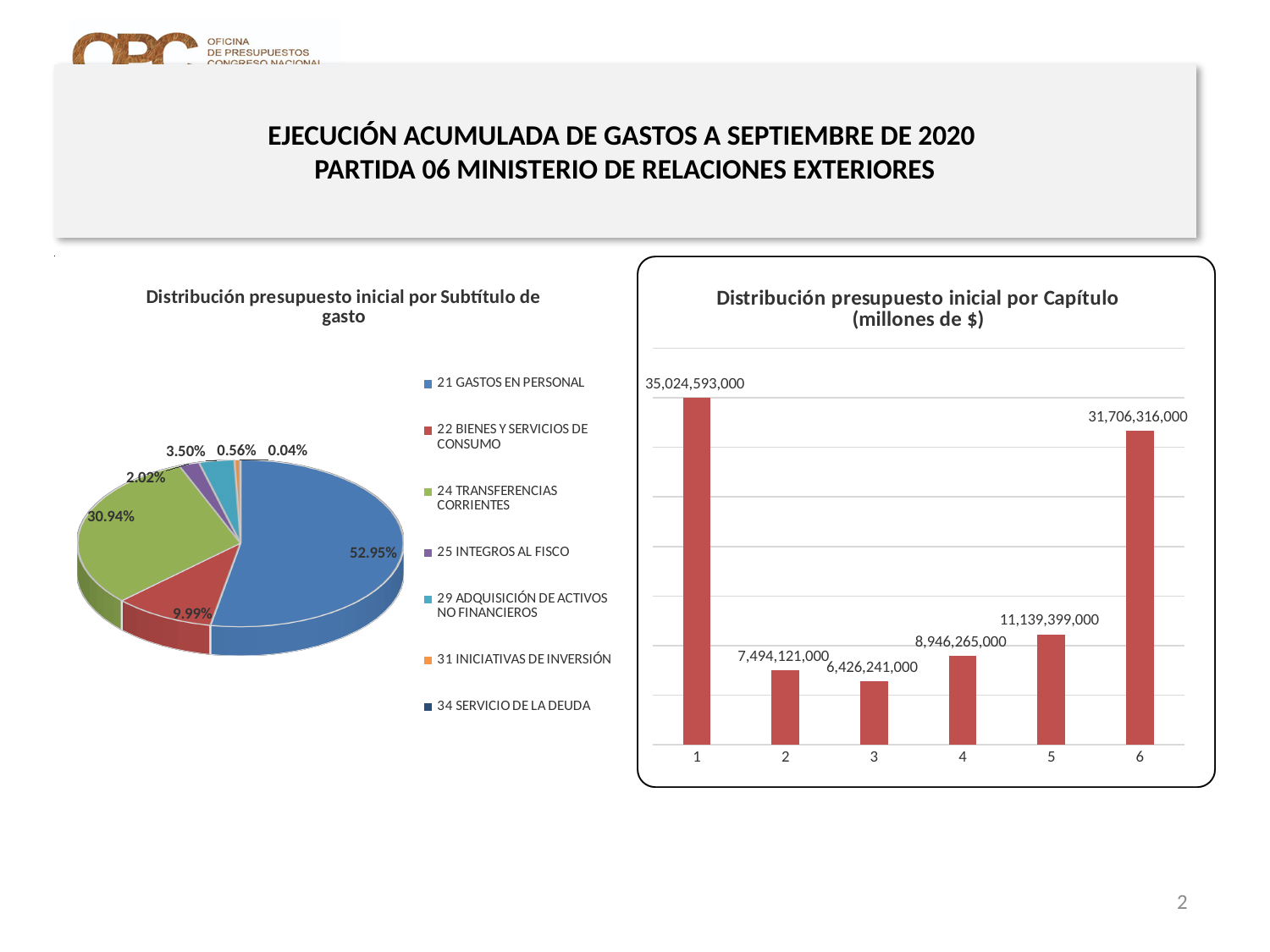
In the pie chart 'Distribución presupuesto inicial por Subtítulo de gasto', which category has the smallest share? 34 SERVICIO DE LA DEUDA In the pie chart 'Distribución presupuesto inicial por Subtítulo de gasto', what share does 24 TRANSFERENCIAS CORRIENTES have? 30.94% In the bar chart 'Distribución presupuesto inicial por Capítulo', what is the value for category 1? 35,024,593,000 In the bar chart 'Distribución presupuesto inicial por Capítulo', which category has the lowest value? 3 In the bar chart 'Distribución presupuesto inicial por Capítulo', which is larger, the value for category 2 or category 4? Category 4 In the pie chart 'Distribución presupuesto inicial por Subtítulo de gasto', what share does 21 GASTOS EN PERSONAL have? 52.95% In the bar chart 'Distribución presupuesto inicial por Capítulo', what is the value for category 6? 31,706,316,000 In the bar chart 'Distribución presupuesto inicial por Capítulo', which category has the highest value? 1 How many categories are shown in the bar chart 'Distribución presupuesto inicial por Capítulo'? 6 In the bar chart 'Distribución presupuesto inicial por Capítulo', what is the difference between the values for category 5 and category 4? 2,193,134,000 In the bar chart 'Distribución presupuesto inicial por Capítulo', what is the value for category 3? 6,426,241,000 How many entries does the legend of the pie chart 'Distribución presupuesto inicial por Subtítulo de gasto' list? 7